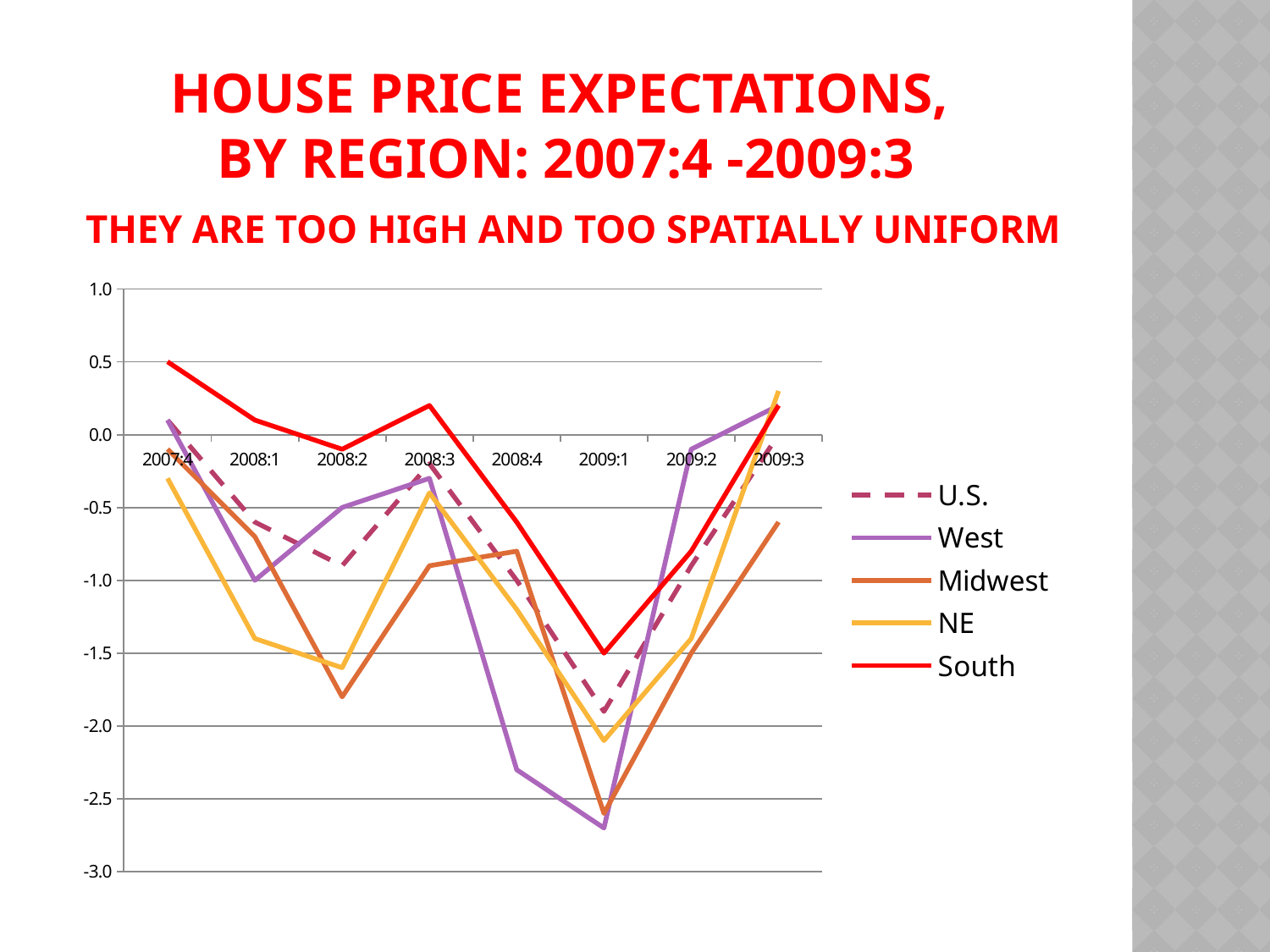
How many series does the legend list? 5 Is the value for West at 2009:1 greater or less than -2.5? less What kind of chart is shown on the slide? line chart What is the value for South at 2007:4? 0.5 What is the value for South at 2009:1? -1.5 How many time periods are plotted along the x axis? 8 Is the value for Midwest at 2008:2 greater or less than -1.5? less Which series has the highest value at 2007:4? South What is the value for West at 2008:1? -1.0 Is the value for South at 2008:3 greater or less than 0.0? greater Which series is drawn with a dashed line? U.S. Which series has the lowest value at 2009:1? West